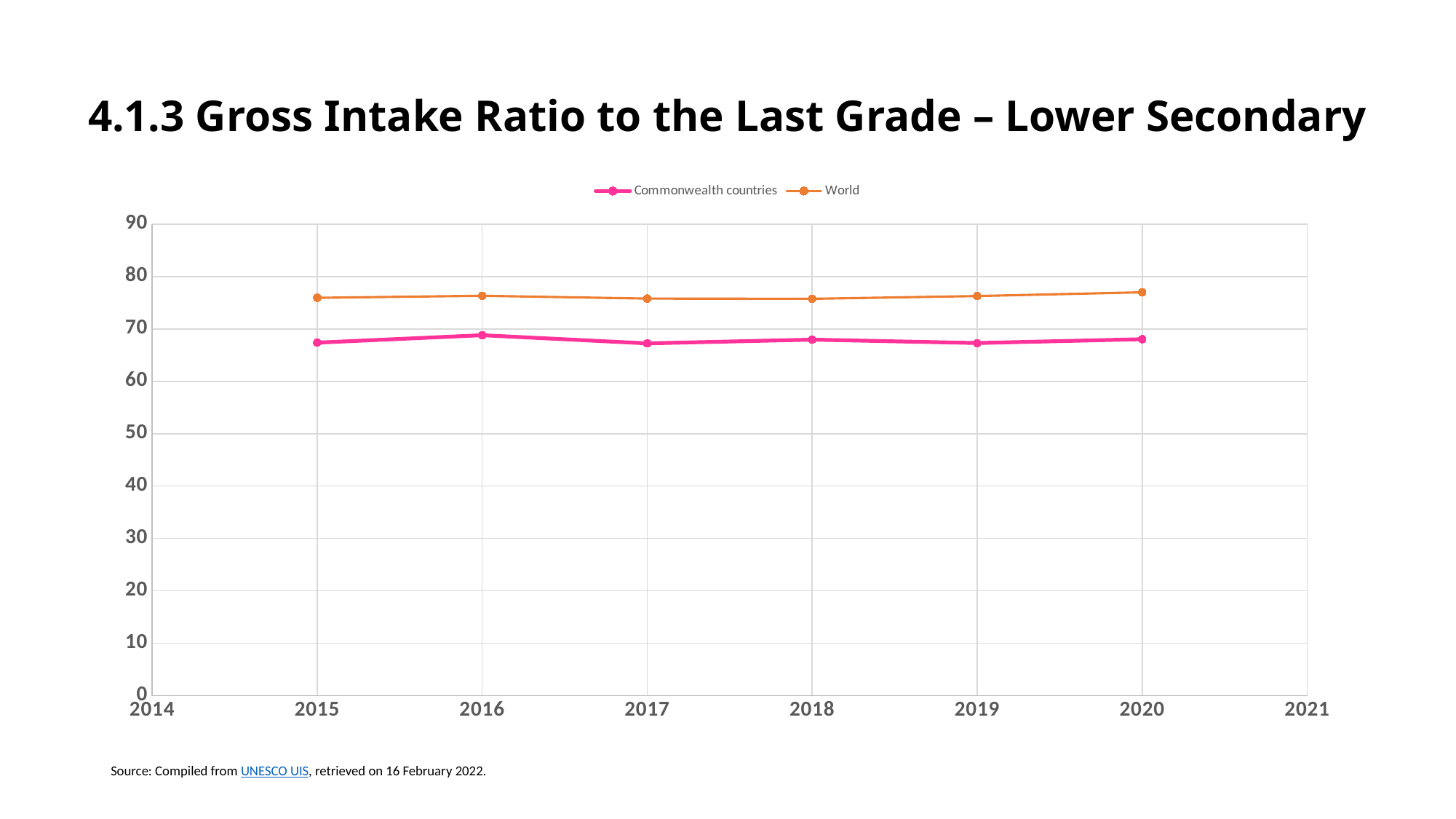
What kind of chart is shown on the slide? line chart Which colour is used for the World series? orange Is the value for Commonwealth countries in 2019 greater or less than 60? greater In which year is the Commonwealth countries value highest? 2016 Is the value for Commonwealth countries in 2016 greater or less than 70? less Which series has the higher value in 2018, Commonwealth countries or World? World Is the value for World in 2020 greater or less than 80? less How many series does the legend list? 2 How many data points are plotted for the World series? 6 Does the Commonwealth countries line rise or fall from 2016 to 2017? fall What is the title of the chart on the slide? 4.1.3 Gross Intake Ratio to the Last Grade – Lower Secondary